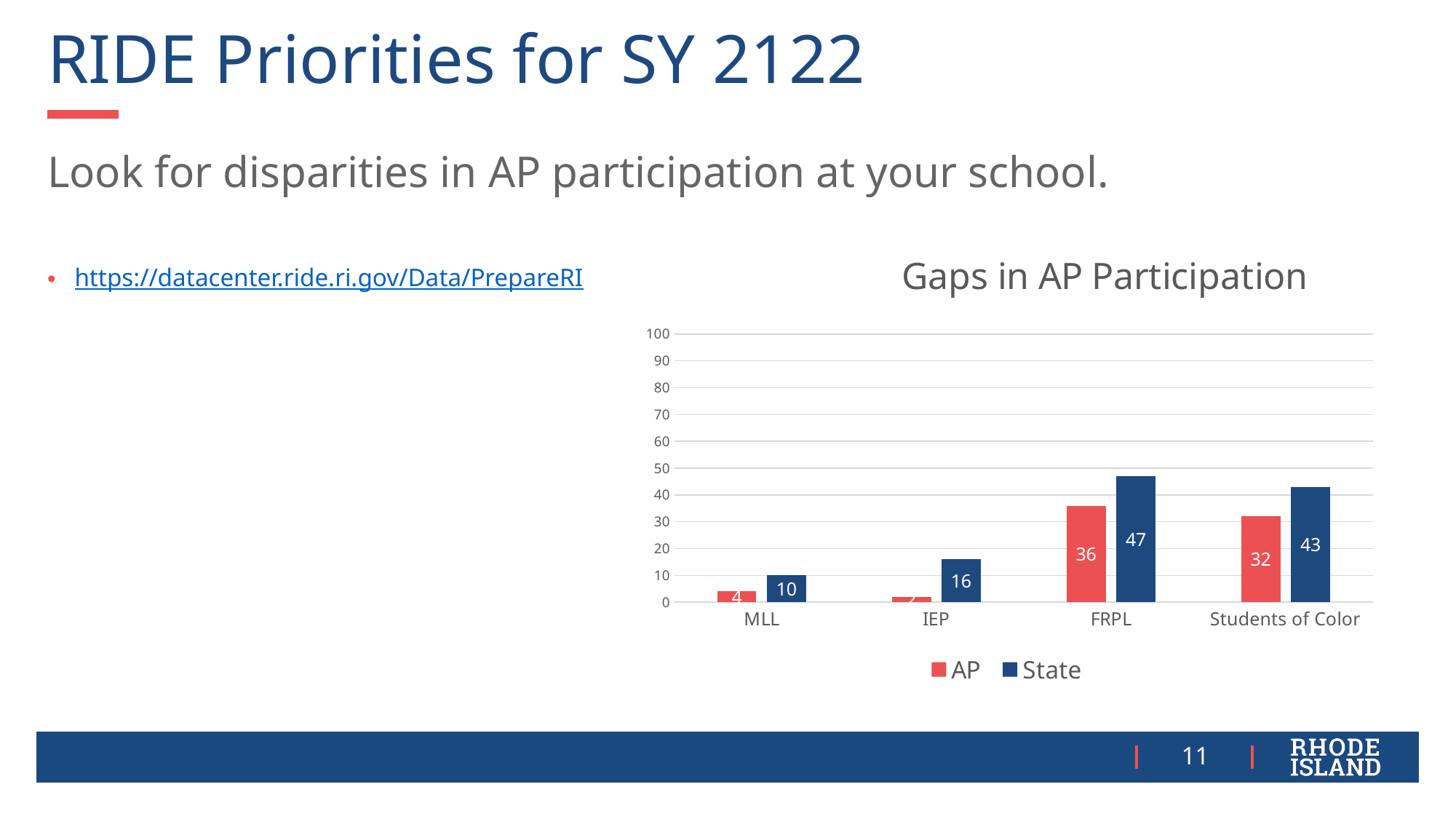
Which category has the highest State value? FRPL Which category has the lowest AP value? IEP How many categories are shown on the x axis? 4 What is the State value for FRPL? 47 What is the AP value for Students of Color? 32 What is the title of the chart? Gaps in AP Participation What is the State value for IEP? 16 What is the difference between the State and AP values for FRPL? 11 What is the State value for MLL? 10 What type of chart is shown on the slide? bar chart Is the AP value for IEP greater or less than 10? less How many series does the legend list? 2